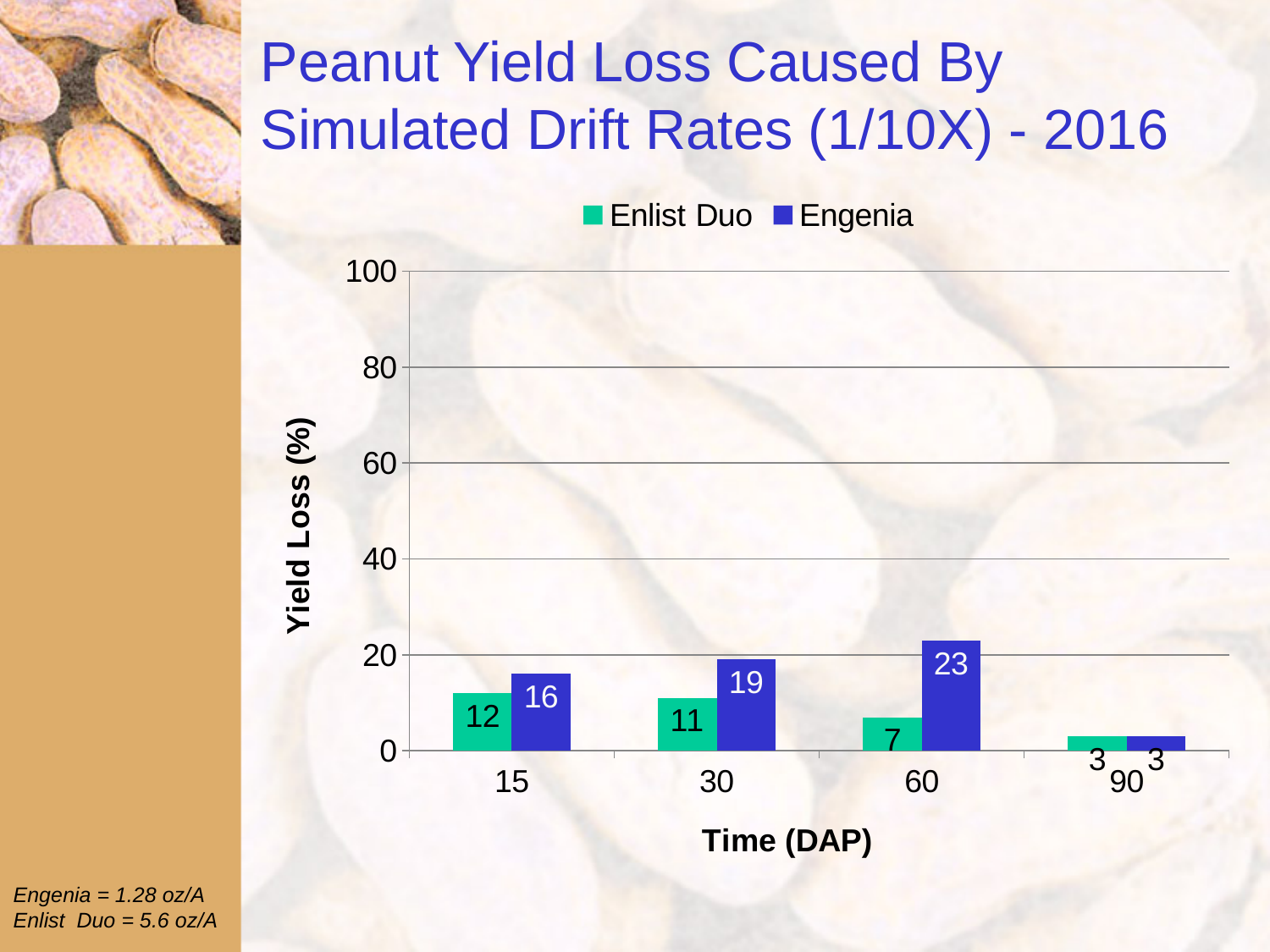
Is the Engenia yield loss at 60 DAP greater or less than 20? greater What is the yield loss for Engenia at 30 DAP? 19 How many series does the legend list? 2 At which time (DAP) is the Engenia yield loss highest? 60 What is the yield loss for Engenia at 60 DAP? 23 What is the difference between the Engenia and Enlist Duo yield loss at 60 DAP? 16 At which time (DAP) is the Enlist Duo yield loss lowest? 90 How many time points (DAP) are shown on the x axis? 4 What is the yield loss for Enlist Duo at 15 DAP? 12 Which has the larger yield loss at 30 DAP, Enlist Duo or Engenia? Engenia What is the label of the y axis? Yield Loss (%) What kind of chart is shown on the slide? Bar chart